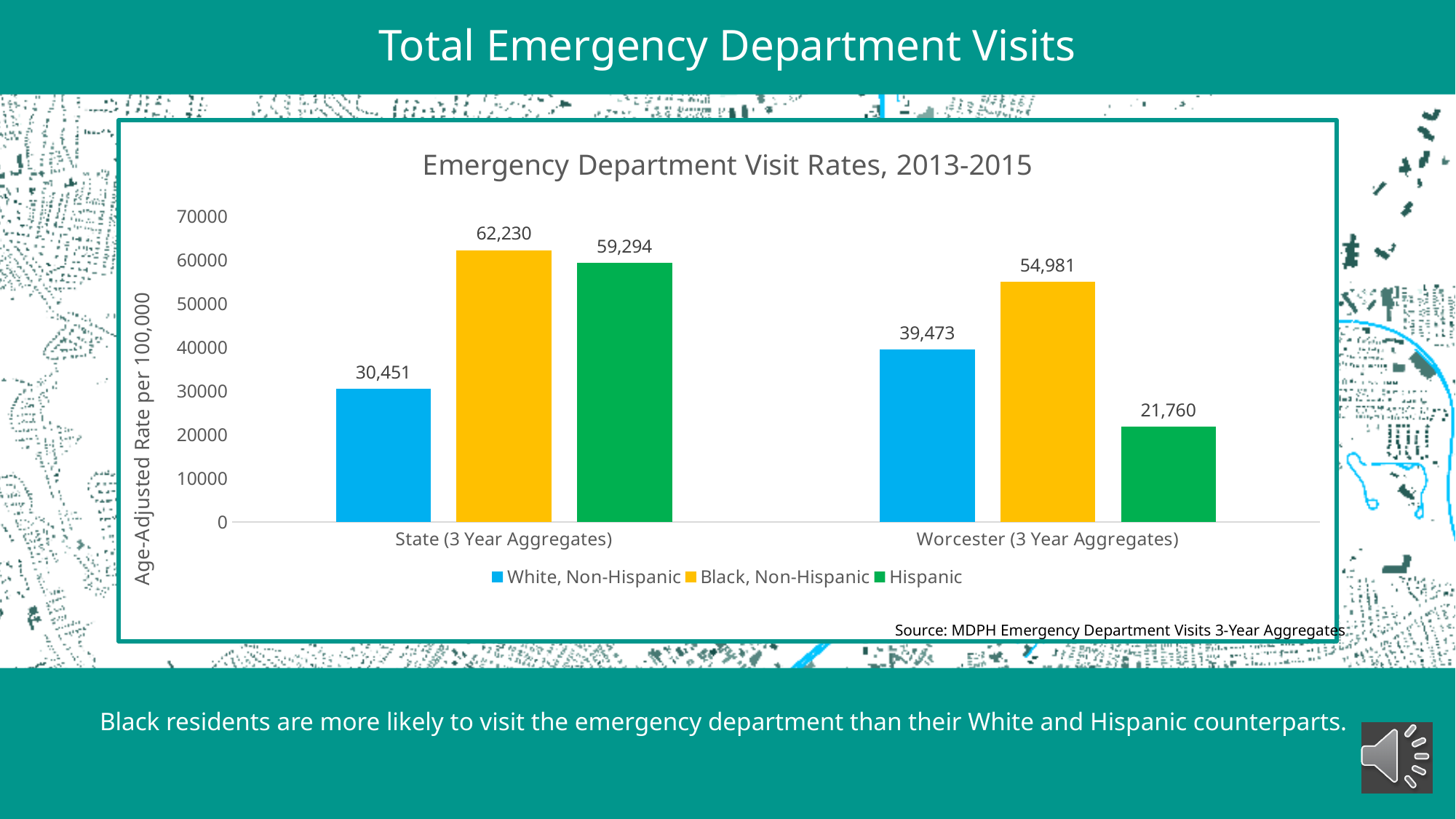
What is the emergency department visit rate for White, Non-Hispanic residents in Worcester (3 Year Aggregates)? 39,473 Which series has the lowest value in the State (3 Year Aggregates) group? White, Non-Hispanic What kind of chart is shown on the slide? Bar chart What is the emergency department visit rate for Hispanic residents in Worcester (3 Year Aggregates)? 21,760 Which series has the highest value in the Worcester (3 Year Aggregates) group? Black, Non-Hispanic Is the Hispanic rate for Worcester (3 Year Aggregates) greater or less than 30000? less How many series does the legend list? 3 What is the title of the chart? Emergency Department Visit Rates, 2013-2015 What is the difference between the Hispanic rate for the State and the Hispanic rate for Worcester? 37,534 Which is larger: the White, Non-Hispanic rate for the State or the White, Non-Hispanic rate for Worcester? Worcester What is the emergency department visit rate for Black, Non-Hispanic residents in the State (3 Year Aggregates) group? 62,230 What is the difference between the Black, Non-Hispanic rate and the White, Non-Hispanic rate in the State (3 Year Aggregates) group? 31,779